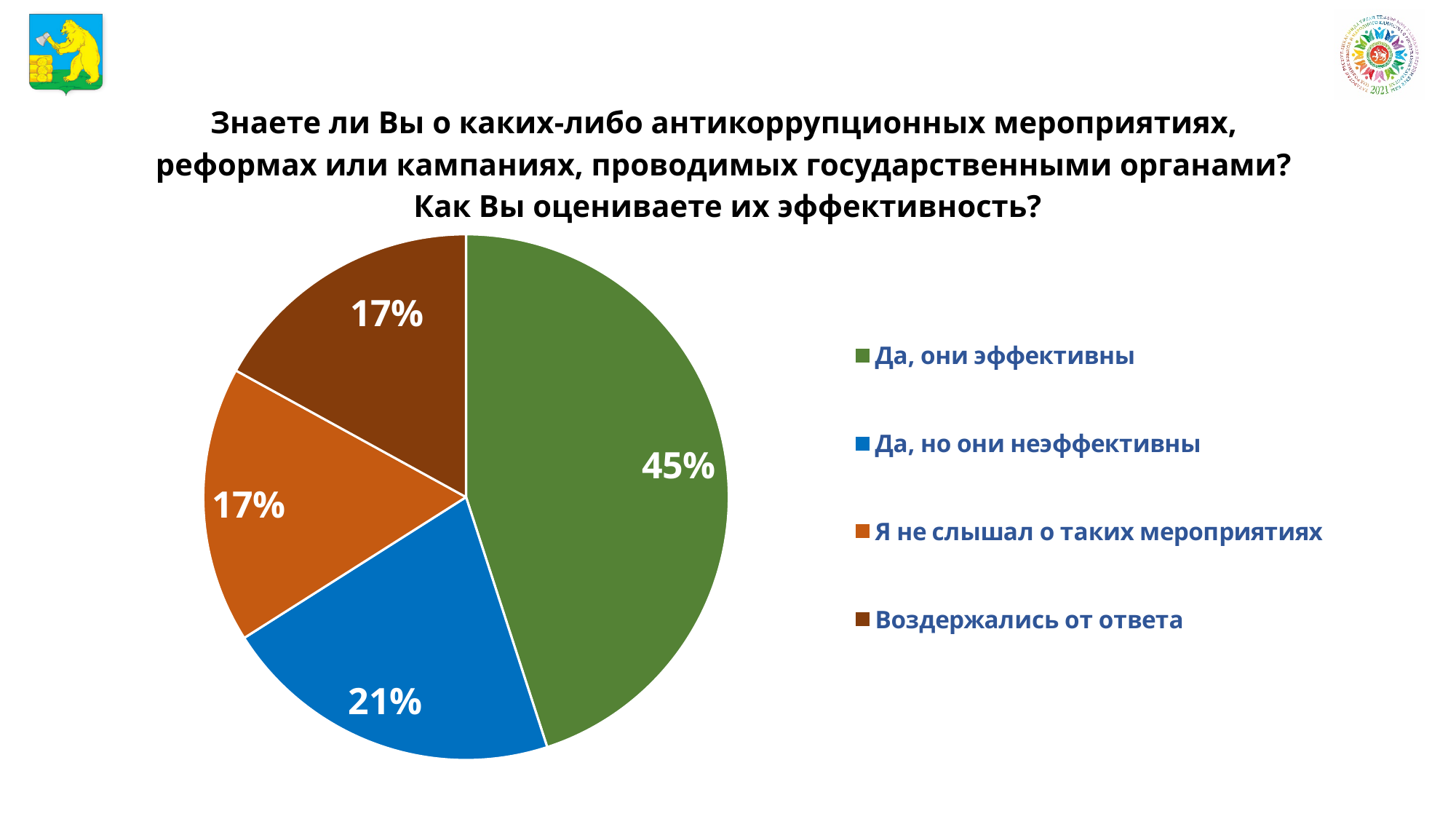
How many categories does the pie chart show? 4 What share of the pie is labelled "Я не слышал о таких мероприятиях"? 17% What share of the pie is labelled "Да, но они неэффективны"? 21% What share of the pie is labelled "Да, они эффективны"? 45% What share of the pie is labelled "Воздержались от ответа"? 17% What kind of chart is shown on the slide? Pie chart Which is larger: the slice for "Да, но они неэффективны" or the slice for "Воздержались от ответа"? Да, но они неэффективны What is the difference in percentage points between "Да, они эффективны" and "Да, но они неэффективны"? 24 Which category has the largest slice of the pie? Да, они эффективны What is the combined share of "Я не слышал о таких мероприятиях" and "Воздержались от ответа"? 34% Which legend entry is shown in blue? Да, но они неэффективны What colour is the slice for "Да, они эффективны"? Green